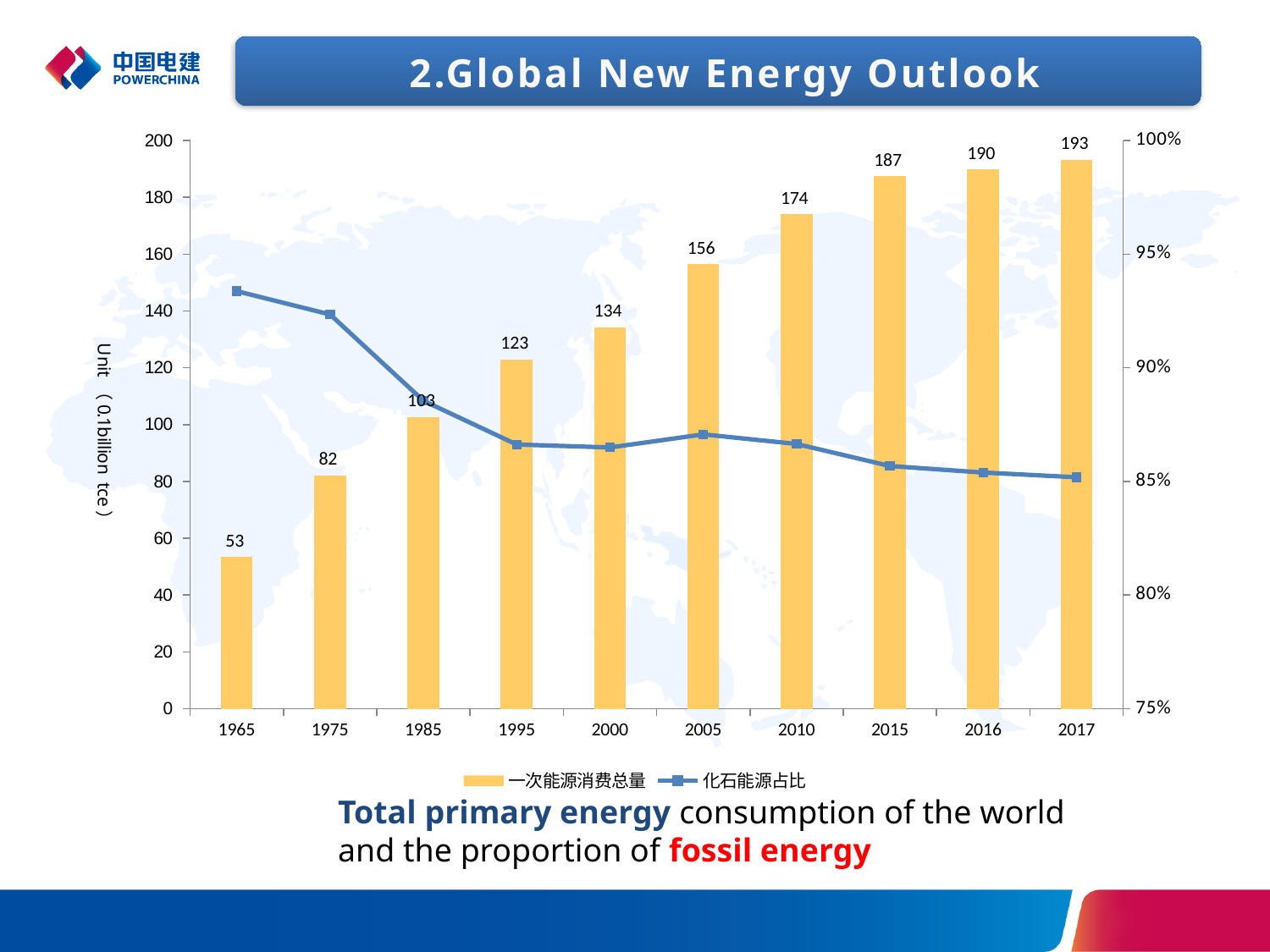
Is the fossil energy proportion (line) for 2017 greater or less than 90%? less What is the total primary energy consumption value for 2017? 193 What is the total primary energy consumption value for 1965? 53 What is the difference between the total primary energy consumption in 2010 and in 2000? 40 Does the fossil energy proportion line generally rise or fall from 1965 to 2017? fall What is the total primary energy consumption value for 2005? 156 How many series does the chart legend list? 2 How many years are shown on the x axis of the chart? 10 Is the fossil energy proportion (line) for 1965 greater or less than 90%? greater Which year has the lowest total primary energy consumption bar? 1965 Which is larger, the total primary energy consumption bar for 1995 or for 1985? 1995 Which year has the highest total primary energy consumption bar? 2017